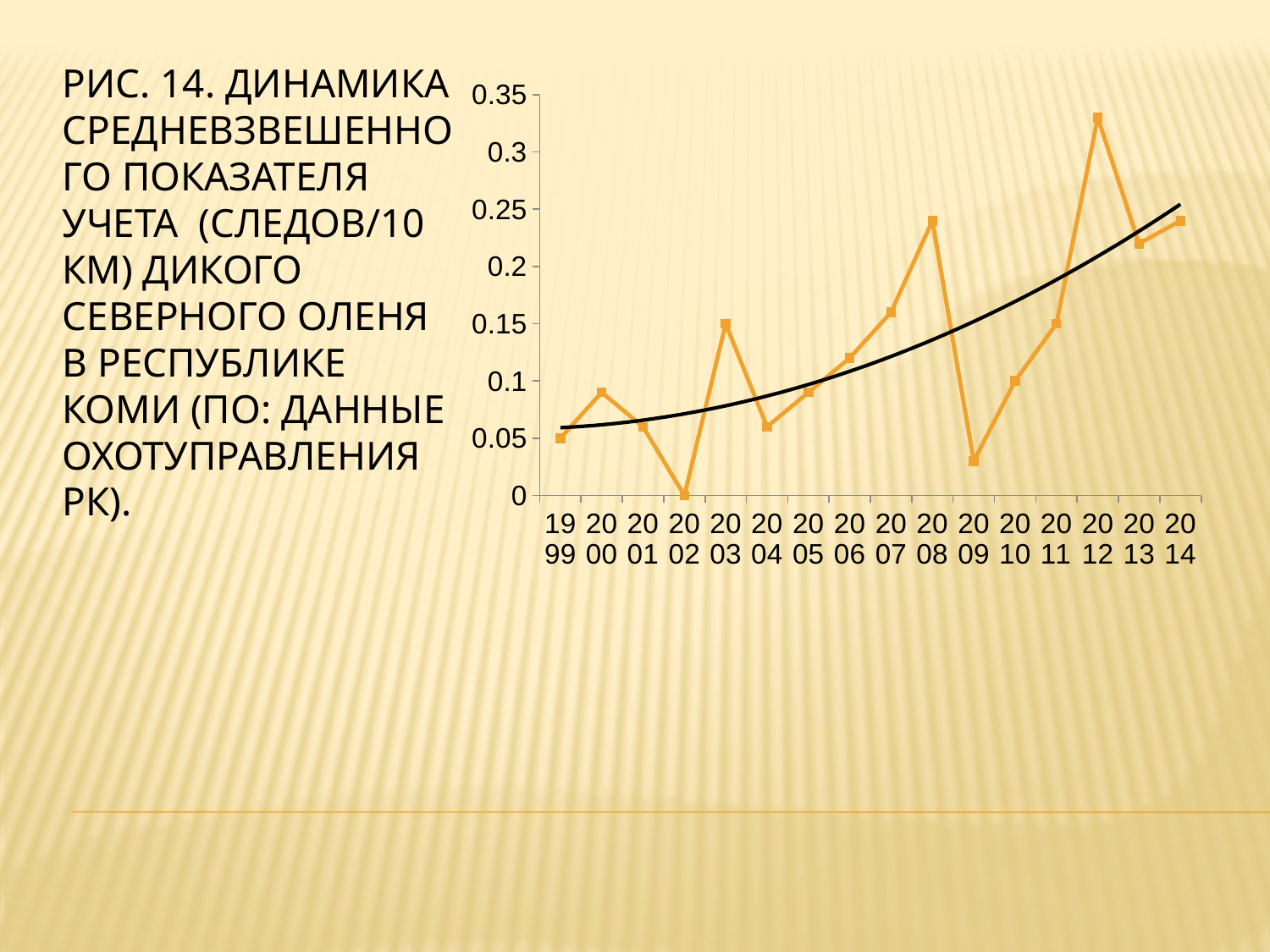
Which year has the larger value, 2008 or 2009? 2008 Which year has the larger value, 2003 or 2004? 2003 According to the black trend line, do the values generally rise or fall from 1999 to 2014? rise What kind of chart is shown on the slide? line chart Is the value for 2012 greater or less than 0.3? greater What is the value for 2002? 0 Is the value for 2009 greater or less than 0.05? less Which year has the highest value on the chart? 2012 Which year has the lowest value on the chart? 2002 How many years are plotted along the x axis? 16 Is the value for 2008 greater or less than 0.2? greater